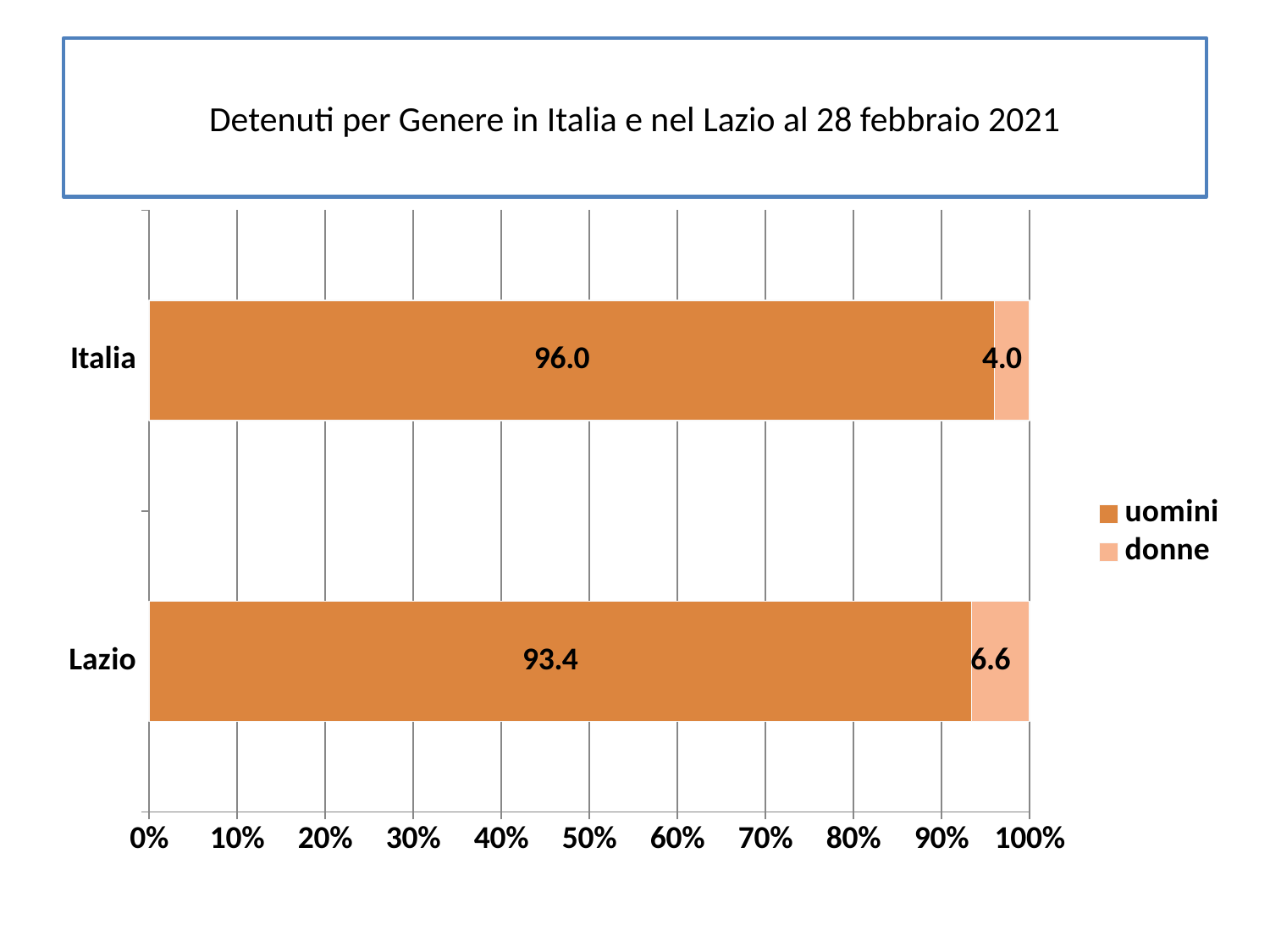
What kind of chart is shown on the slide? Stacked bar chart What is the value for uomini in Lazio? 93.4 What is the value for uomini in Italia? 96.0 What is the difference between the donne values for Lazio and Italia? 2.6 What is the difference between the uomini values for Italia and Lazio? 2.6 How many categories are shown on the chart? 2 Which category has the higher value for uomini, Italia or Lazio? Italia What is the value for donne in Italia? 4.0 Which category has the higher value for donne, Italia or Lazio? Lazio How many series does the legend list? 2 What is the title of the chart? Detenuti per Genere in Italia e nel Lazio al 28 febbraio 2021 What is the value for donne in Lazio? 6.6